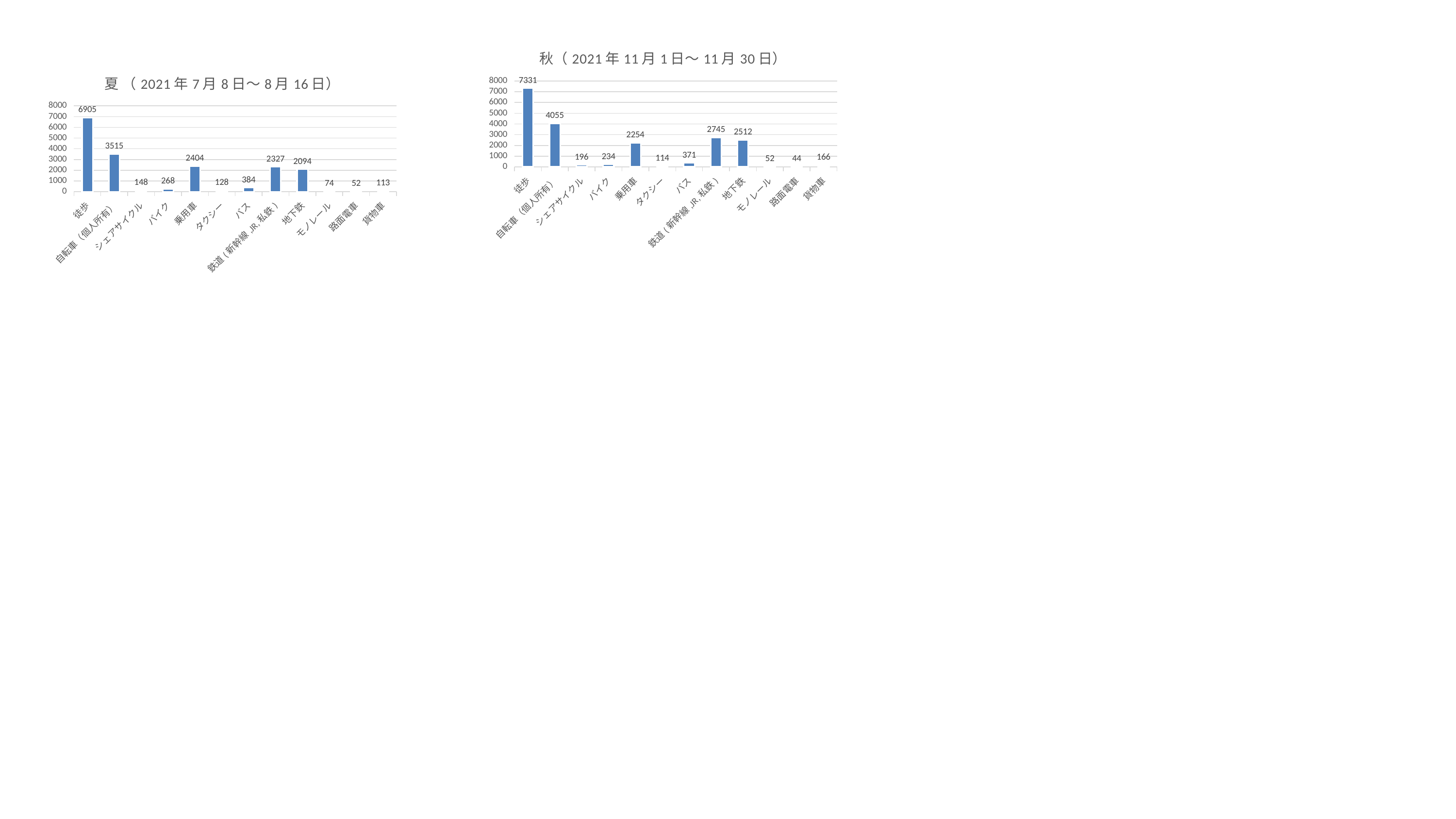
What kind of chart is the 秋 (2021年11月1日～11月30日) chart? bar chart In the 秋 (2021年11月1日～11月30日) chart, what is the value for 自転車（個人所有）? 4055 In the 秋 chart, what is the difference between 徒歩 and 自転車（個人所有）? 3276 In the 秋 chart, which category has the lowest value? 路面電車 In the 夏 chart, what is the value for バス? 384 What is the title of the chart on the left of the slide? 夏（2021年7月8日～8月16日） In the 夏 chart, which is larger, 乗用車 or 地下鉄? 乗用車 In the 夏 chart, which category has the highest value? 徒歩 In the 夏 (2021年7月8日～8月16日) chart, what is the value for 徒歩? 6905 In the 秋 chart, which is larger, 鉄道（新幹線,JR,私鉄） or 地下鉄? 鉄道（新幹線,JR,私鉄） In the 夏 chart, which category has the lowest value? 路面電車 How many categories are shown in the 夏 chart? 12